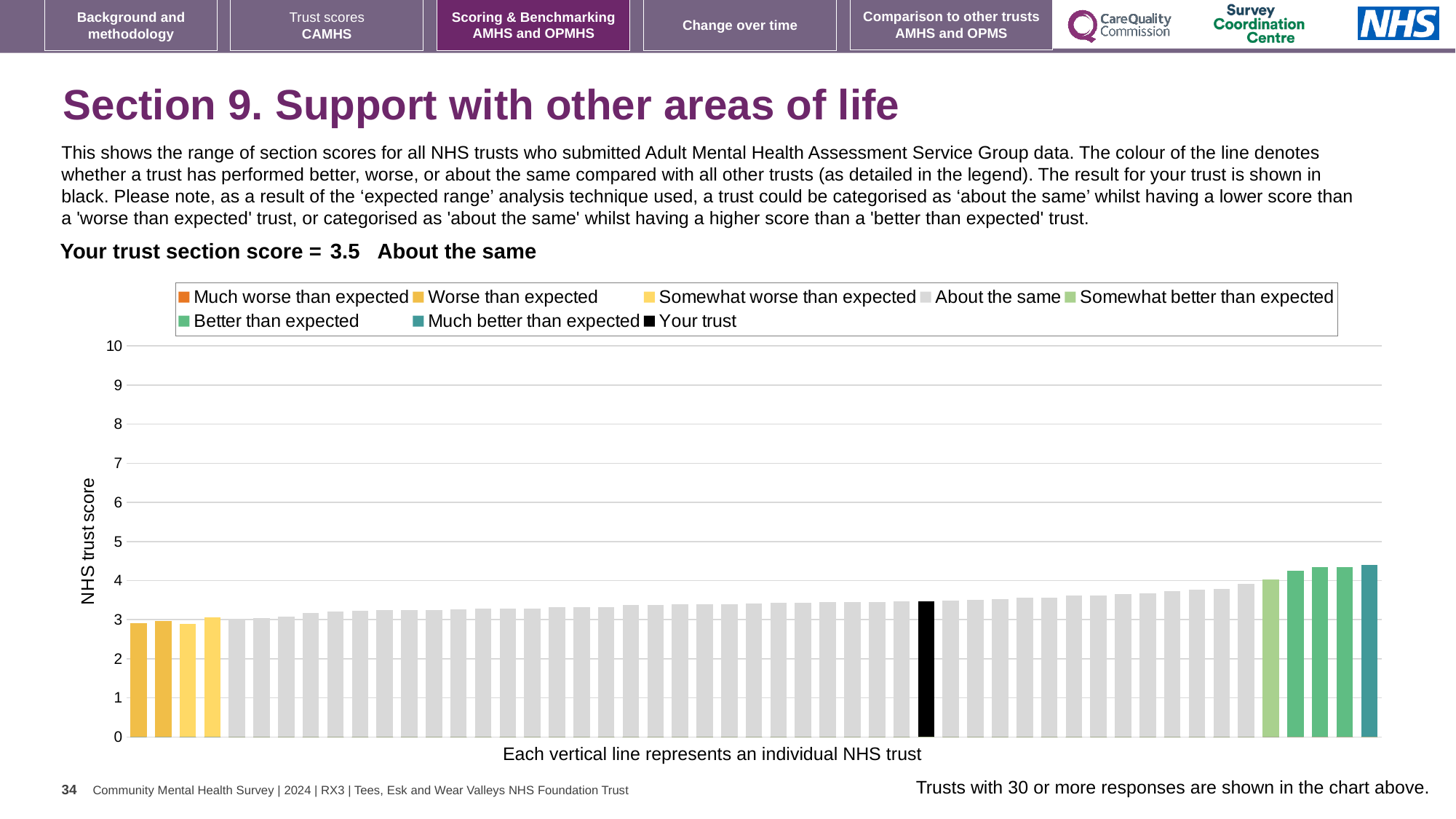
Which category is your trust's section score placed in? About the same Is the value for your trust (the black bar) greater or less than 4? less What is the section score for your trust shown on the slide? 3.5 What is the highest value shown on the vertical axis? 10 Is the value of the tallest bar in the chart greater or less than 4? greater What is the label on the vertical axis of the chart? NHS trust score What kind of chart is shown on the slide? bar chart What colour is the bar representing your trust? black Do the bar values rise or fall from left to right along the x axis? rise Is the value for your trust (the black bar) greater or less than 3? greater How many entries does the chart legend list? 8